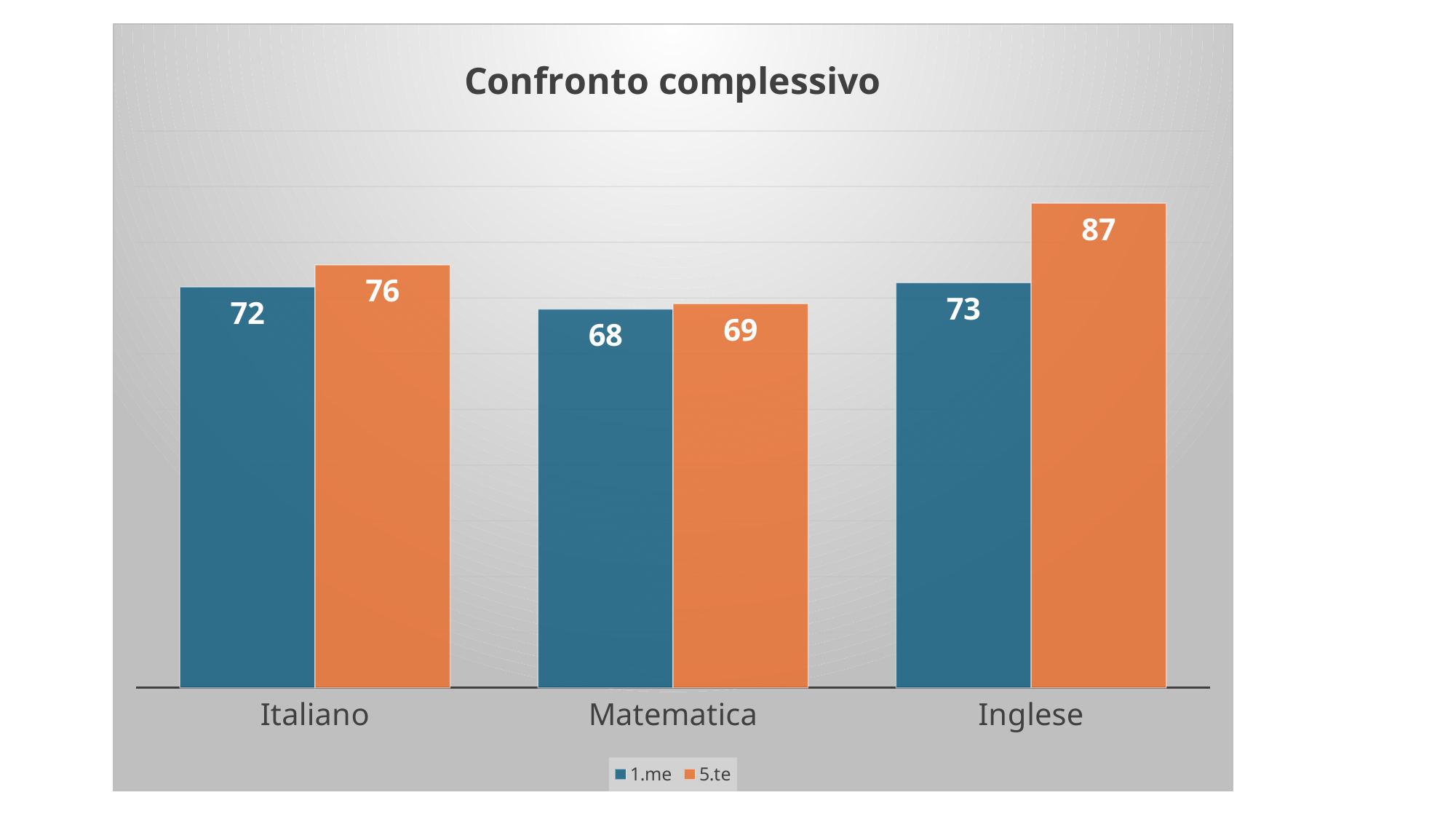
What is the title of the chart? Confronto complessivo Which category has the lowest value for 1.me? Matematica What is the value for 5.te in Inglese? 87 What is the value for 1.me in Matematica? 68 How many series does the legend list? 2 What is the difference between 5.te and 1.me in Italiano? 4 Which category has the highest value for 5.te? Inglese How many categories are shown on the x axis? 3 What is the value for 5.te in Matematica? 69 What is the difference between 5.te and 1.me in Inglese? 14 Which is larger in Italiano, 1.me or 5.te? 5.te What is the value for 1.me in Italiano? 72